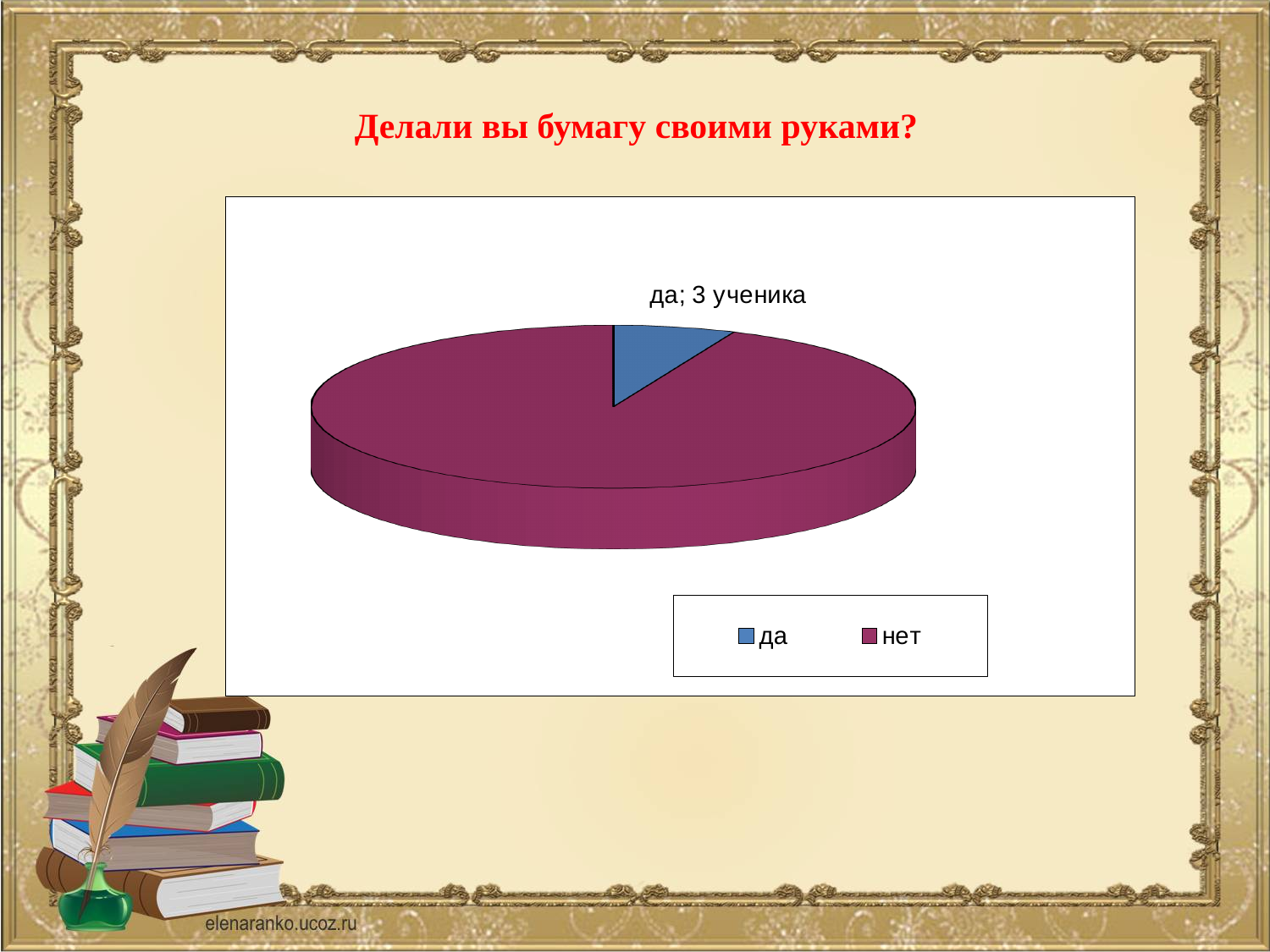
Which slice is larger, "да" or "нет"? нет What kind of chart is shown on the slide? pie chart How many entries does the legend list? 2 Which slice is the smallest in the pie chart? да Which slice is the largest in the pie chart? нет What value is printed for the "да" slice? 3 ученика How many slices does the pie chart have? 2 What colour is the "да" slice? blue What is the title of the slide above the chart? Делали вы бумагу своими руками?